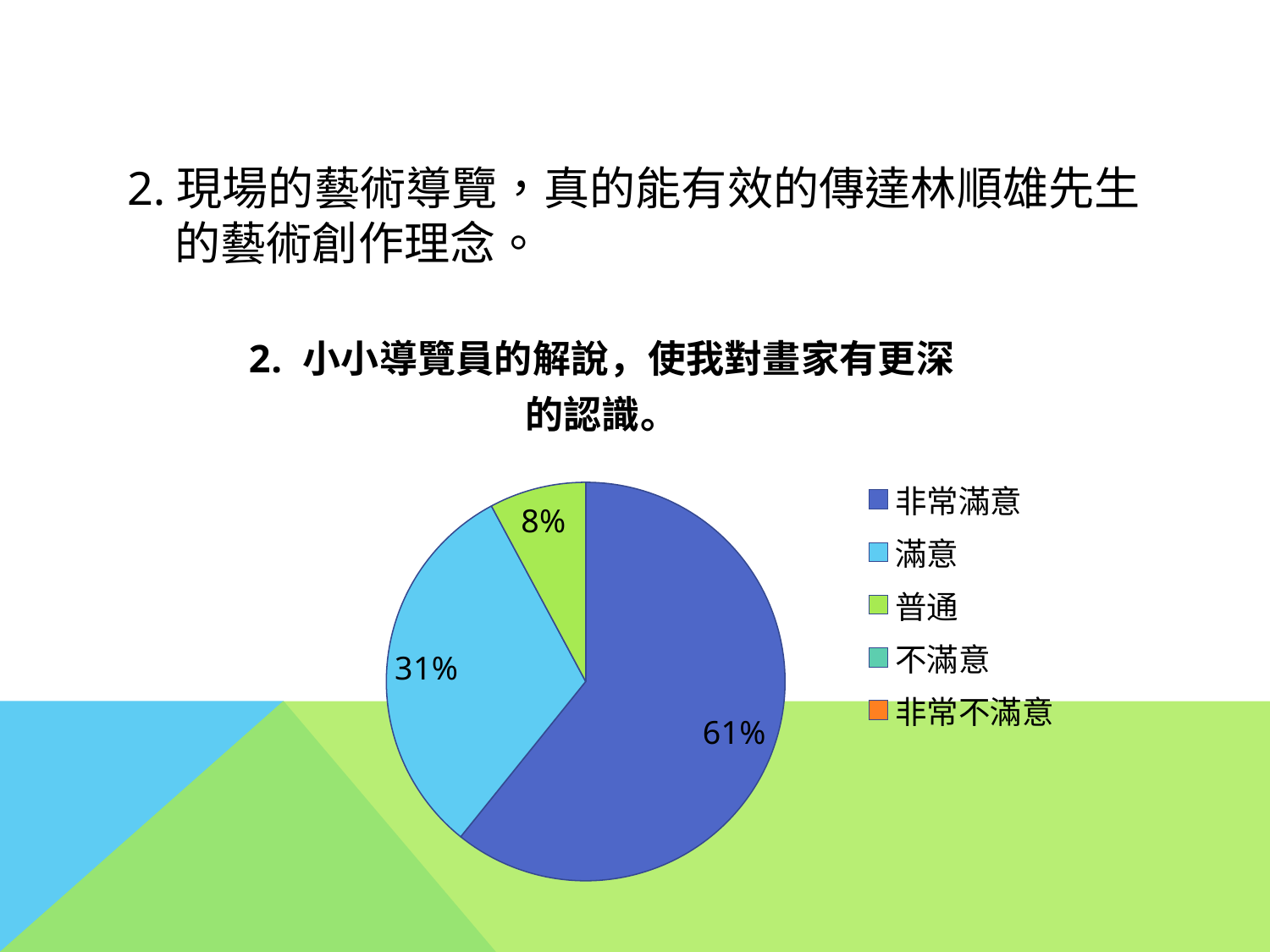
Which is larger, the slice for 滿意 or the slice for 普通? 滿意 How many categories are listed in the legend? 5 What percentage of the pie is 滿意? 31% What is the difference in percentage points between 滿意 and 普通? 23 What type of chart is shown on the slide? pie chart What percentage of the pie is 普通? 8% Which of the three labelled slices is the smallest? 普通 What is the difference in percentage points between 非常滿意 and 滿意? 30 What is the title of the chart? 2. 小小導覽員的解說，使我對畫家有更深的認識。 How many slices of the pie have a percentage label? 3 Which category has the largest slice of the pie? 非常滿意 What percentage of the pie is 非常滿意? 61%